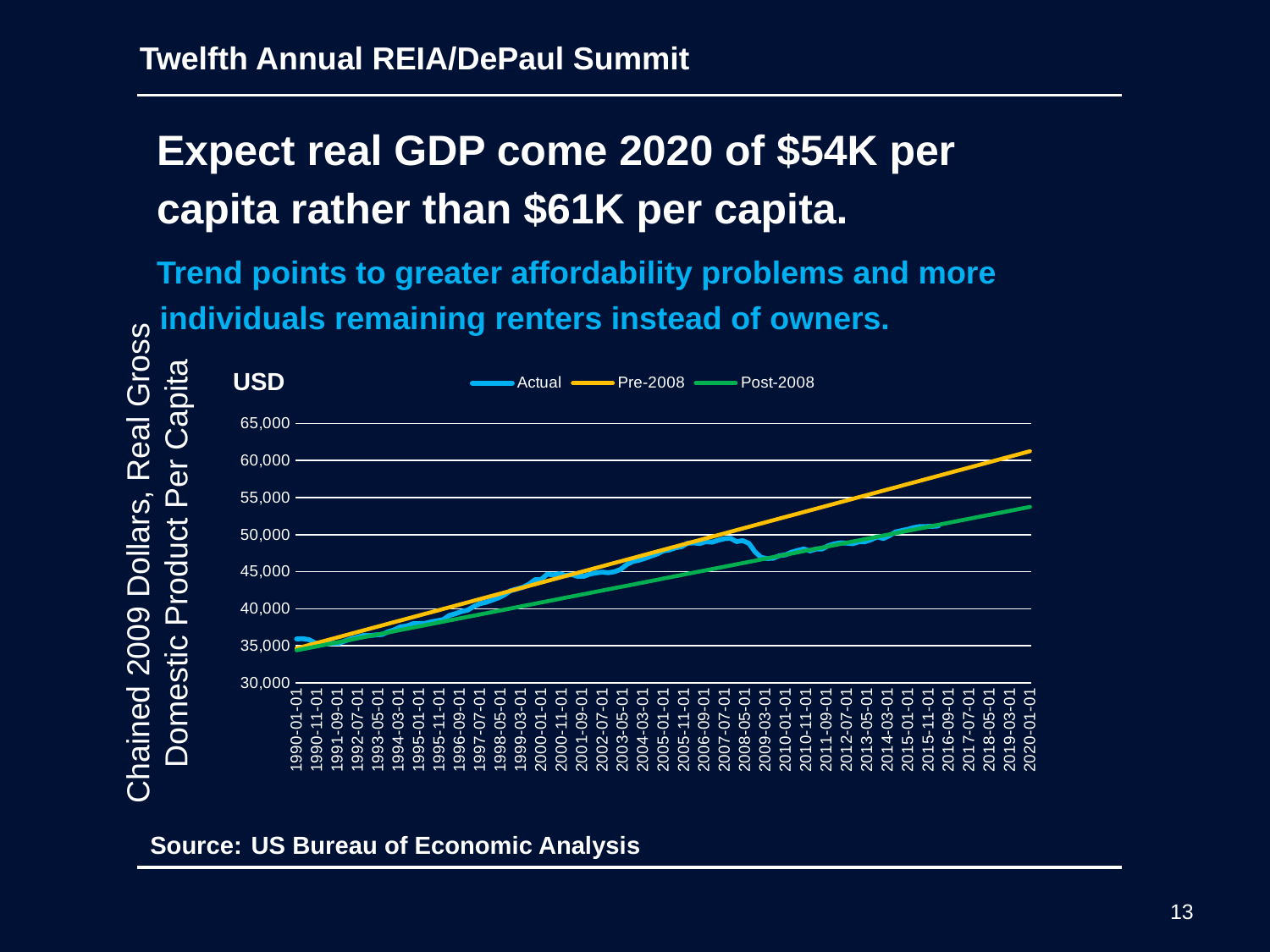
At 2010-01-01, which line is higher: Pre-2008 or Actual? Pre-2008 What unit label is shown at the top left of the chart's vertical axis? USD Is the value of the Post-2008 line at 1990-01-01 greater or less than 35,000? less What are the three series named in the chart's legend? Actual, Pre-2008, Post-2008 What kind of chart is shown on the slide? line chart Is the value of the Actual line at 1990-01-01 greater or less than 35,000? greater How many series does the chart's legend list? 3 Does the Pre-2008 line rise or fall from left to right along the x axis? rise Is the value of the Post-2008 line at 2020-01-01 greater or less than 55,000? less At 2020-01-01, which line is higher: Pre-2008 or Post-2008? Pre-2008 What is the highest value shown on the chart's vertical axis? 65,000